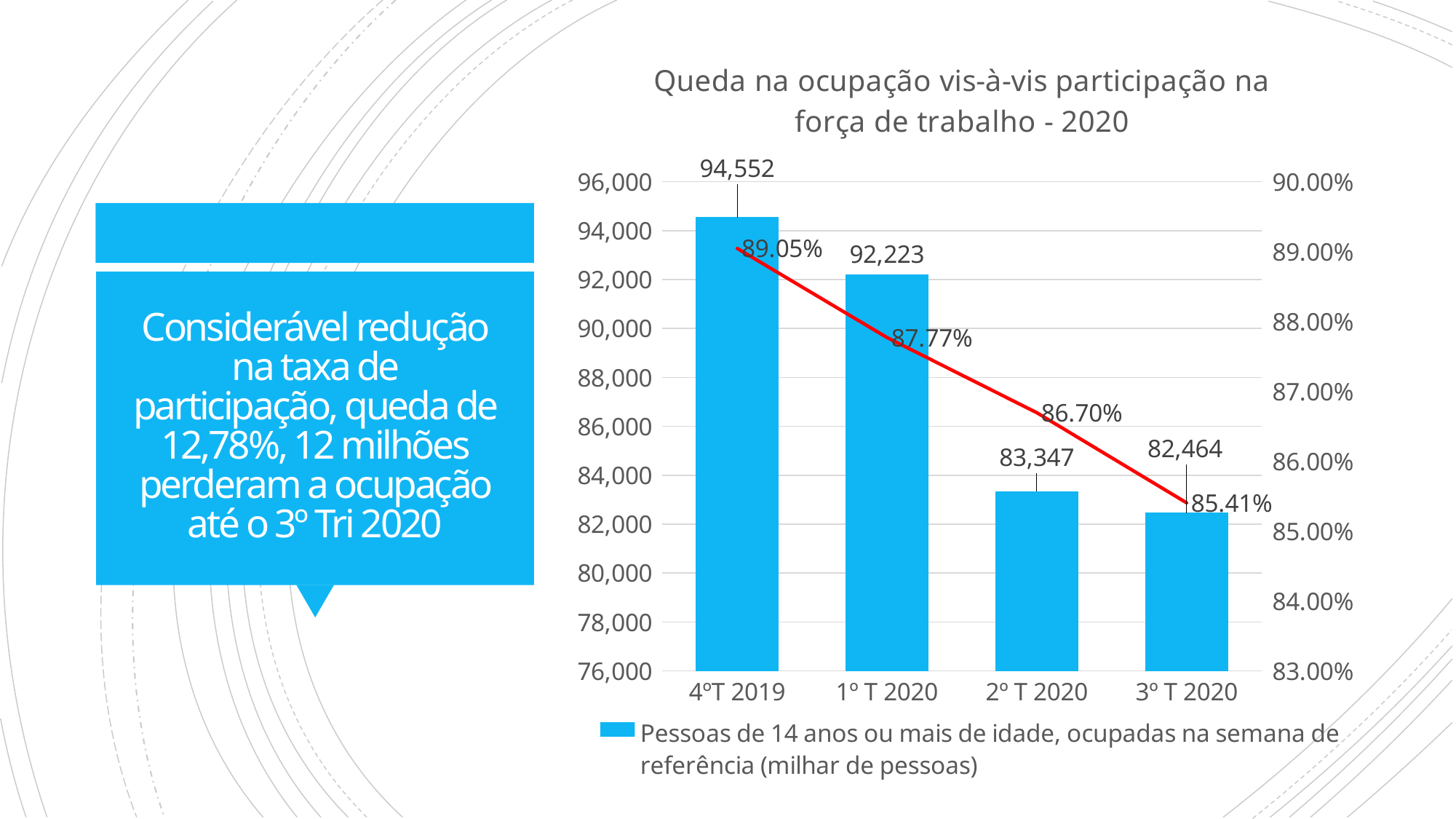
What is the difference between the bar values for 1º T 2020 and 2º T 2020? 8,876 Which quarter has the highest bar value? 4ºT 2019 What percentage does the red line show for 1º T 2020? 87.77% What percentage does the red line show for 2º T 2020? 86.70% What is the title of the chart? Queda na ocupação vis-à-vis participação na força de trabalho - 2020 Do the bar values rise or fall from 4ºT 2019 to 3º T 2020? fall How many quarters are shown on the x axis? 4 What is the value of the bar for 4ºT 2019? 94,552 What is the value of the bar for 3º T 2020? 82,464 Which quarter has the lowest bar value? 3º T 2020 Which is larger, the bar value for 2º T 2020 or for 3º T 2020? 2º T 2020 What is the difference between the bar values for 4ºT 2019 and 3º T 2020? 12,088